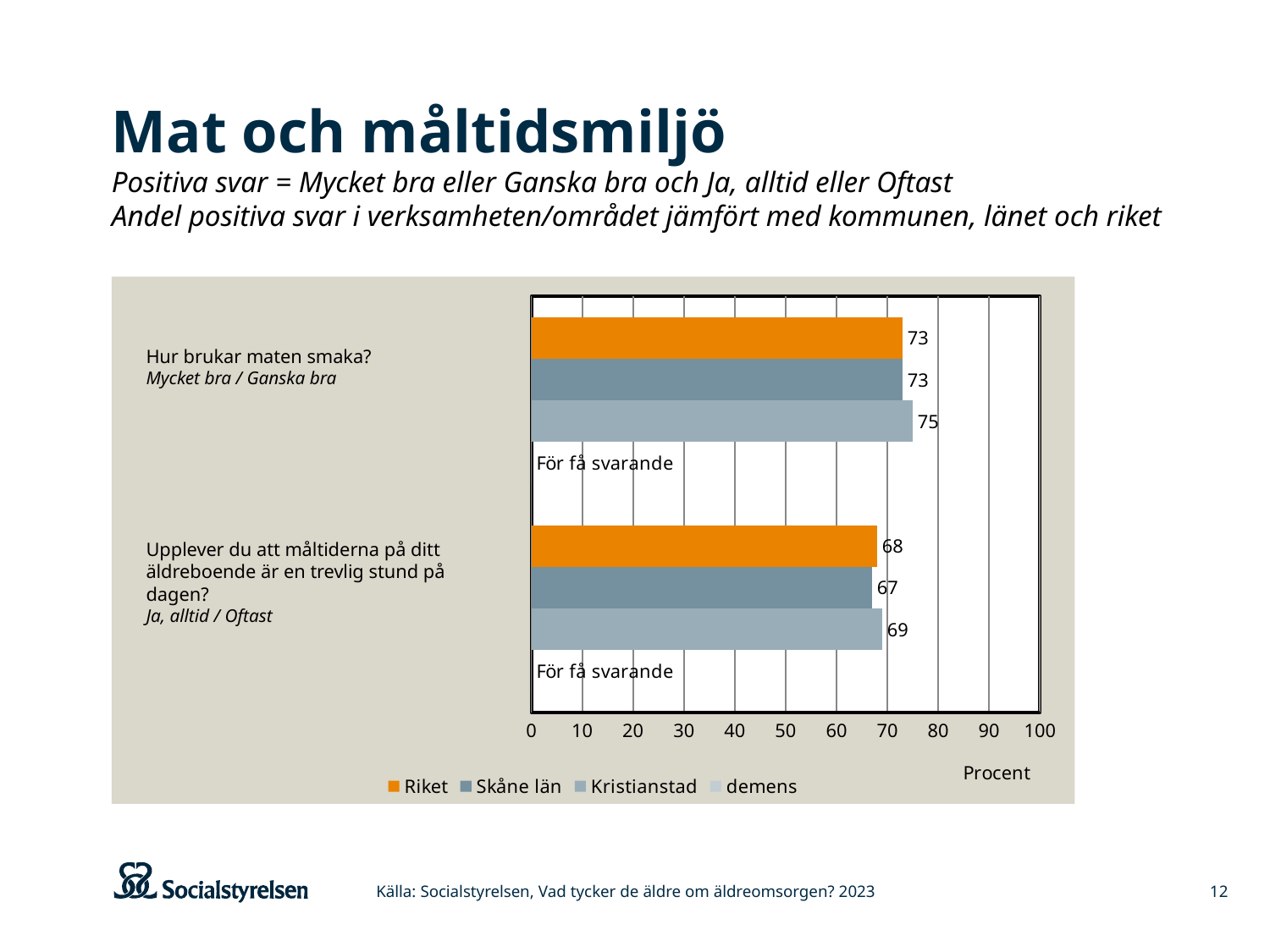
How many series does the legend list? 4 What is the value for Riket for the question "Upplever du att måltiderna på ditt äldreboende är en trevlig stund på dagen?"? 68 What is the difference between the Kristianstad value and the Skåne län value for the question "Upplever du att måltiderna på ditt äldreboende är en trevlig stund på dagen?"? 2 Which series has the highest value for the question "Upplever du att måltiderna på ditt äldreboende är en trevlig stund på dagen?"? Kristianstad Which is larger: the Riket value for "Hur brukar maten smaka?" or the Riket value for "Upplever du att måltiderna på ditt äldreboende är en trevlig stund på dagen?"? Hur brukar maten smaka? What kind of chart is shown on the slide? bar chart What is the difference between the Kristianstad value and the Riket value for the question "Hur brukar maten smaka?"? 2 What is shown for the demens series instead of a bar? För få svarande What is the label on the x axis of the chart? Procent What is the value for Kristianstad for the question "Hur brukar maten smaka?"? 75 What is the value for Skåne län for the question "Upplever du att måltiderna på ditt äldreboende är en trevlig stund på dagen?"? 67 What is the value for Riket for the question "Hur brukar maten smaka?"? 73